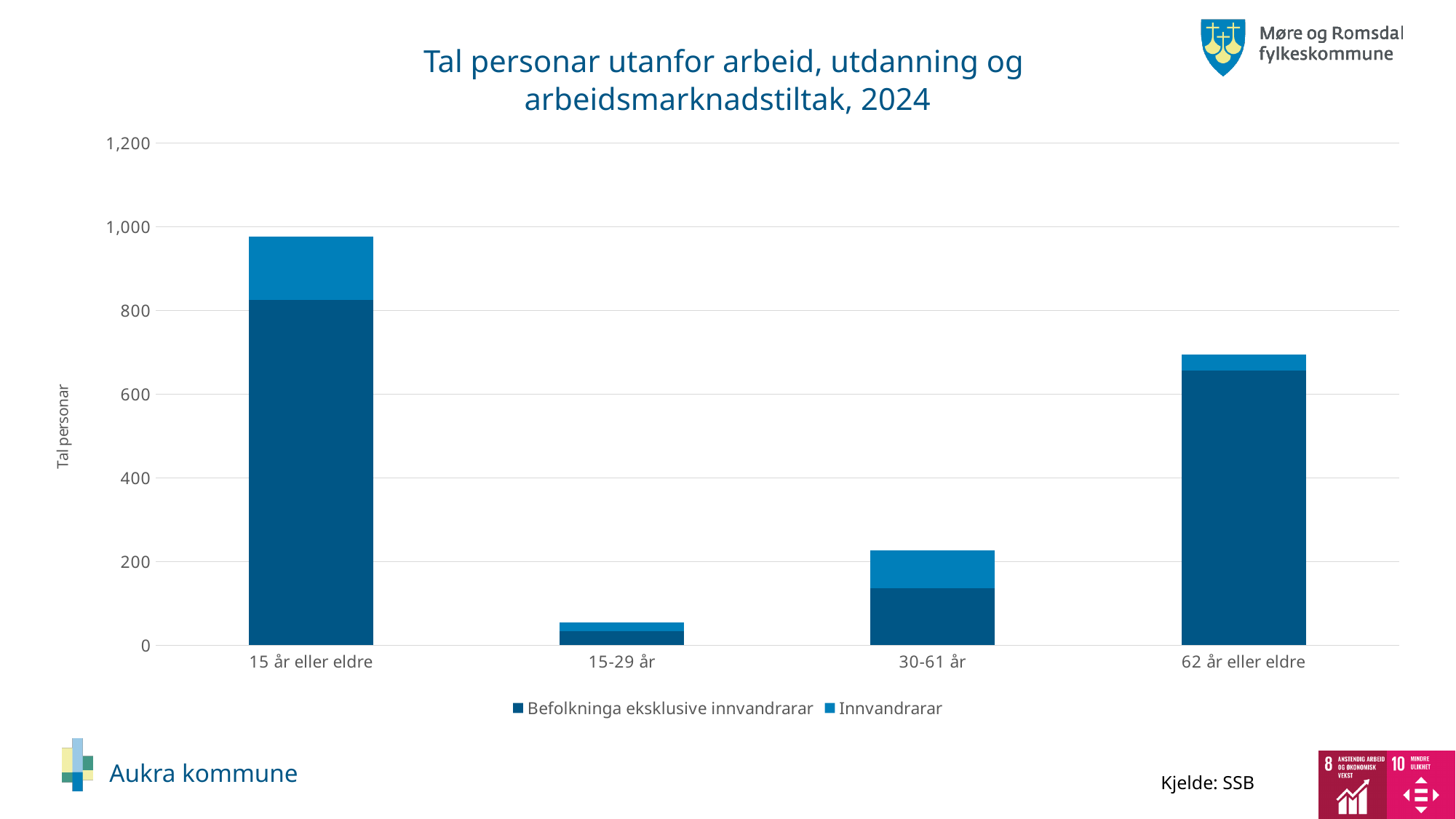
Is the total stacked bar for 62 år eller eldre greater or less than 600? greater How many series does the legend list? 2 How many age categories are shown on the x axis? 4 Which category has the tallest stacked bar? 15 år eller eldre Is the total stacked bar for 30-61 år greater or less than 400? less What kind of chart is shown on the slide? Stacked bar chart What is the label of the y axis? Tal personar Is the total stacked bar for 15 år eller eldre greater or less than 800? greater What is the title of the chart? Tal personar utanfor arbeid, utdanning og arbeidsmarknadstiltak, 2024 Which category has the shortest stacked bar? 15-29 år Which has a taller stacked bar, 30-61 år or 62 år eller eldre? 62 år eller eldre